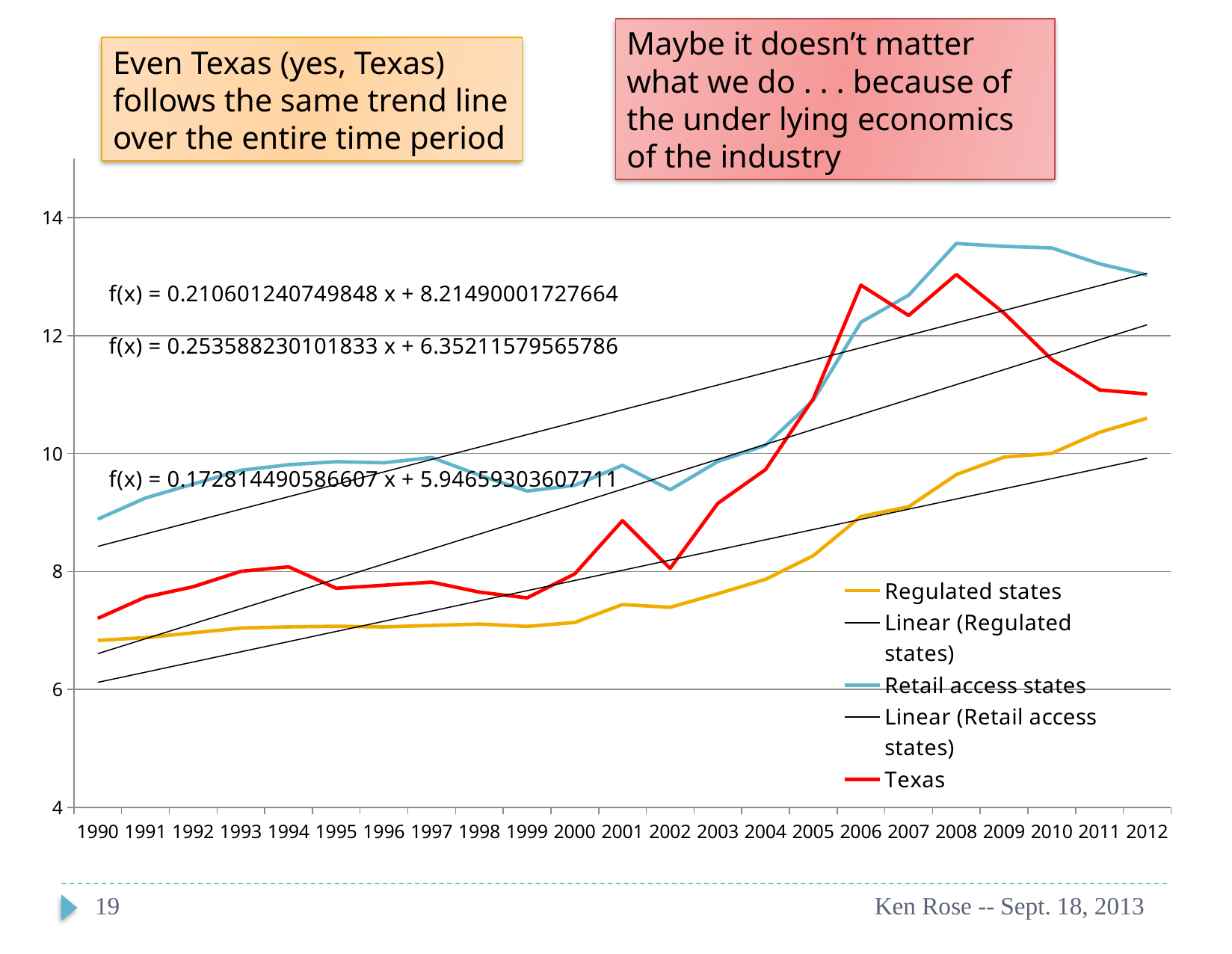
Is the value for Texas in 2006 greater or less than 12? greater Is the value for Texas in 1990 greater or less than 8? less How many entries does the legend list? 5 Does the Regulated states line generally rise or fall from 1990 to 2012? rise In 2001, which is higher, Texas or Regulated states? Texas What kind of chart is shown on the slide? line chart In which year is the Retail access states line at its lowest? 1990 How many years are shown along the x axis? 23 Is the value for Retail access states in 2008 greater or less than 12? greater In which year is the Regulated states line at its highest? 2012 In 2012, which is higher, Retail access states or Texas? Retail access states